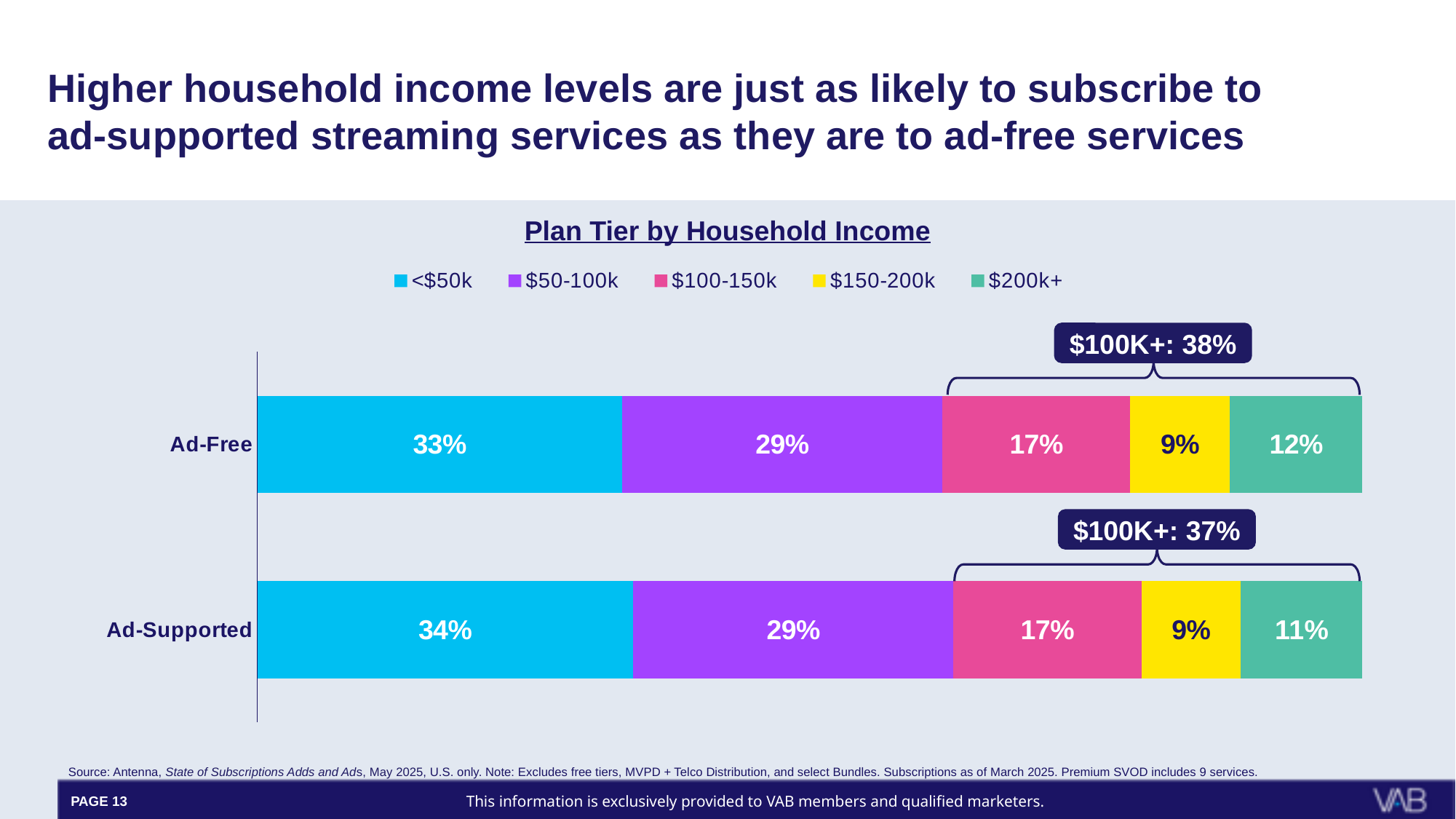
What is the value for the $200k+ segment of the Ad-Supported bar? 11% What is the value for the <$50k segment of the Ad-Free bar? 33% Which income segment is the smallest in the Ad-Free bar? $150-200k Which income segment is the largest in the Ad-Supported bar? <$50k What kind of chart is shown on the slide? Stacked bar chart Which is larger: the $200k+ value for Ad-Free or for Ad-Supported? Ad-Free How many income series does the legend list? 5 What is the difference between the <$50k values for Ad-Supported and Ad-Free? 1% What is the title of the chart? Plan Tier by Household Income What is the value for the $150-200k segment of the Ad-Free bar? 9% What is the value for the $50-100k segment of the Ad-Supported bar? 29% How many plan tiers (bars) are shown in the chart? 2